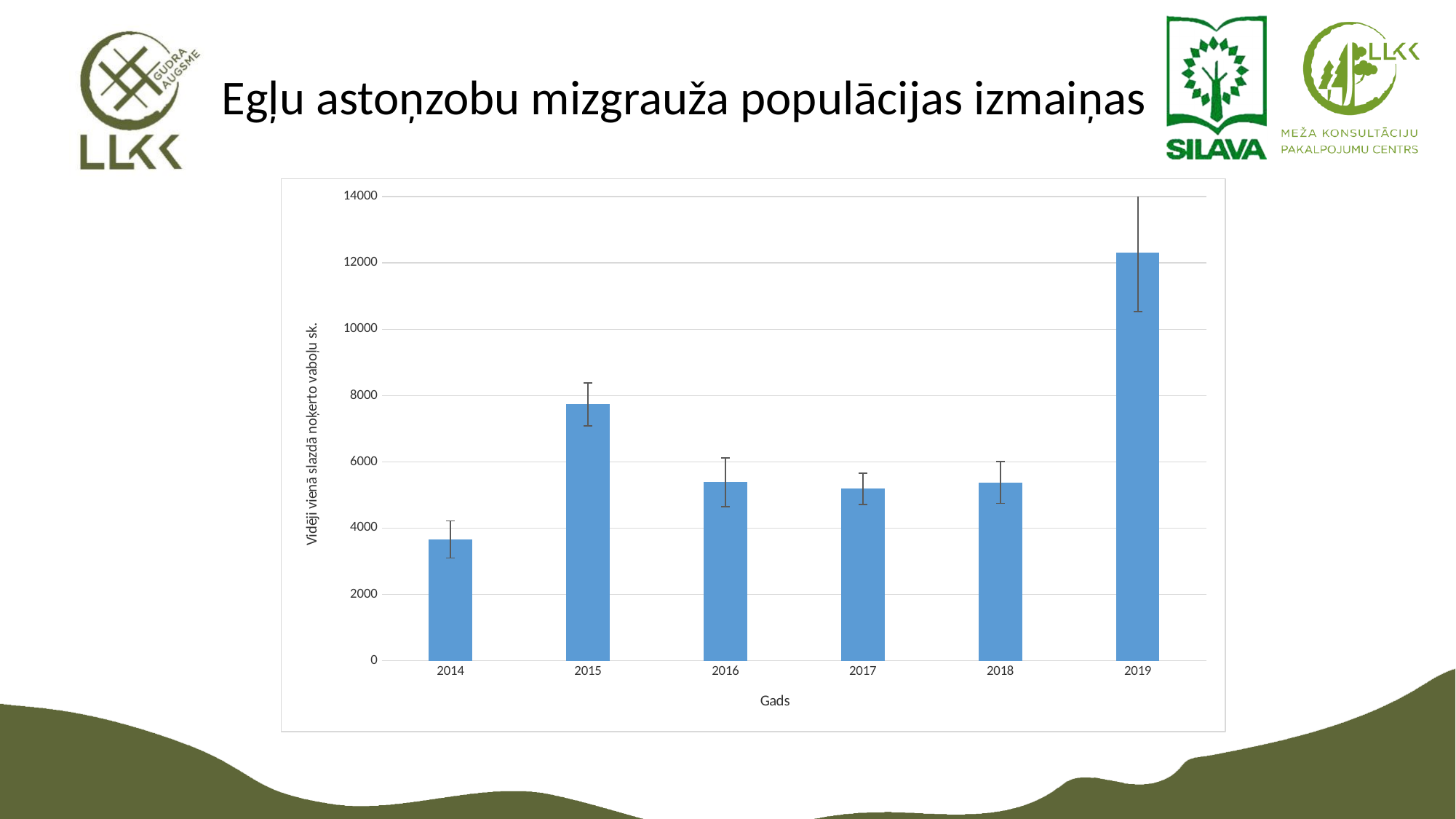
Is the value for 2014 greater or less than 4000? less Which year has the highest value in the chart? 2019 Which year has the larger value, 2015 or 2016? 2015 Which year has the larger value, 2014 or 2018? 2018 Does the value rise or fall from 2018 to 2019? rise What kind of chart is shown on the slide? bar chart Is the value for 2015 greater or less than 6000? greater How many years are shown on the x axis of the chart? 6 Is the value for 2017 greater or less than 6000? less Which year has the lowest value in the chart? 2014 What is the title of the x axis of the chart? Gads